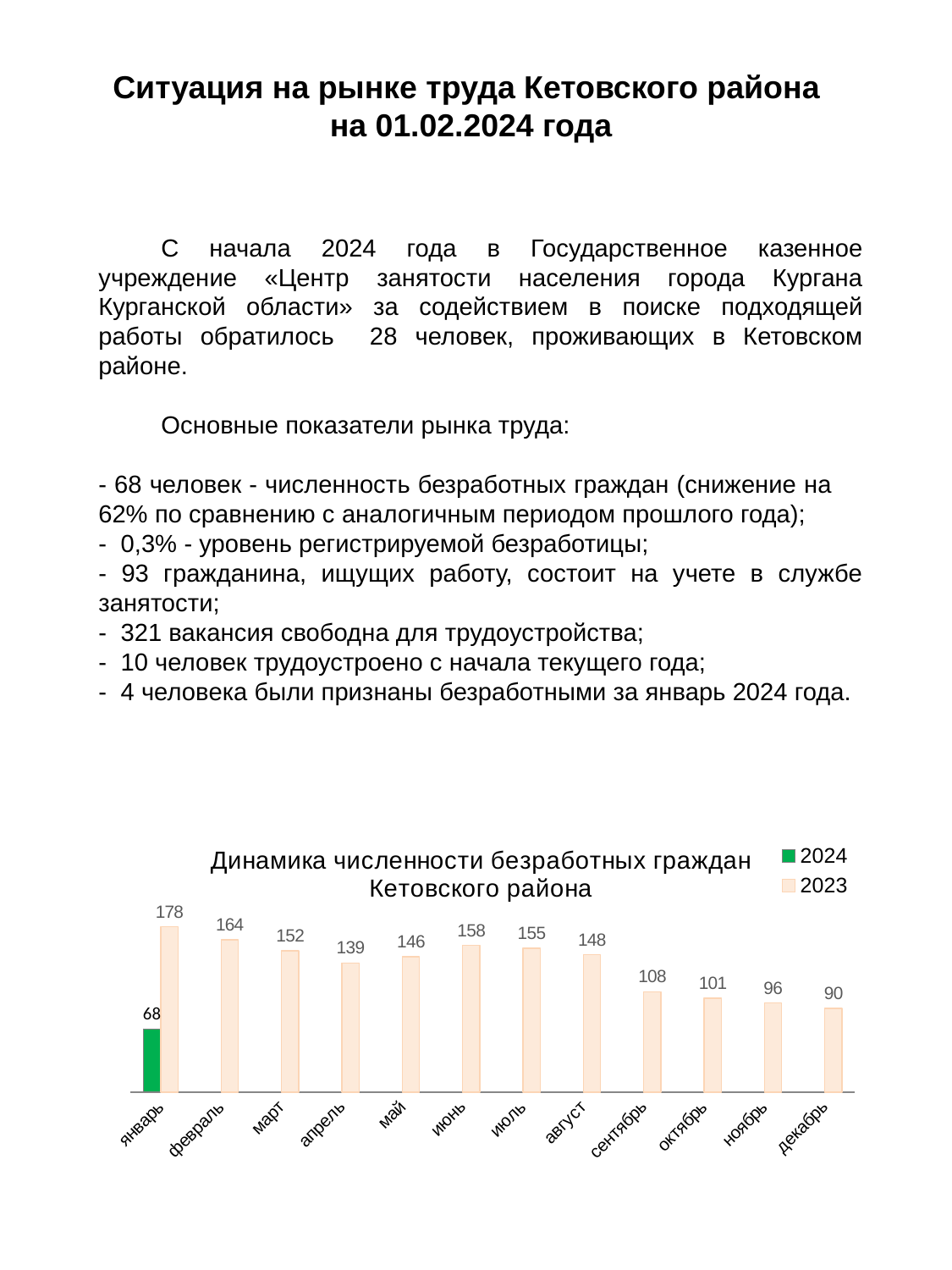
What is the difference between the 2023 and 2024 values for январь in the chart? 110 What kind of chart is "Динамика численности безработных граждан Кетовского района"? bar chart Do the 2023 values generally rise or fall from август to декабрь in the chart? fall Which month has the highest 2023 value in the chart? январь What is the value for 2023 in январь in the chart "Динамика численности безработных граждан Кетовского района"? 178 What colour are the 2024 bars in the chart? green How many series does the legend of the chart list? 2 What is the 2023 value for декабрь in the chart? 90 Which month has the lowest 2023 value in the chart? декабрь How many months are shown on the x axis of the chart? 12 Which is larger in the chart: the 2023 value for июнь or the 2023 value for май? июнь What is the value for 2024 in январь in the chart? 68